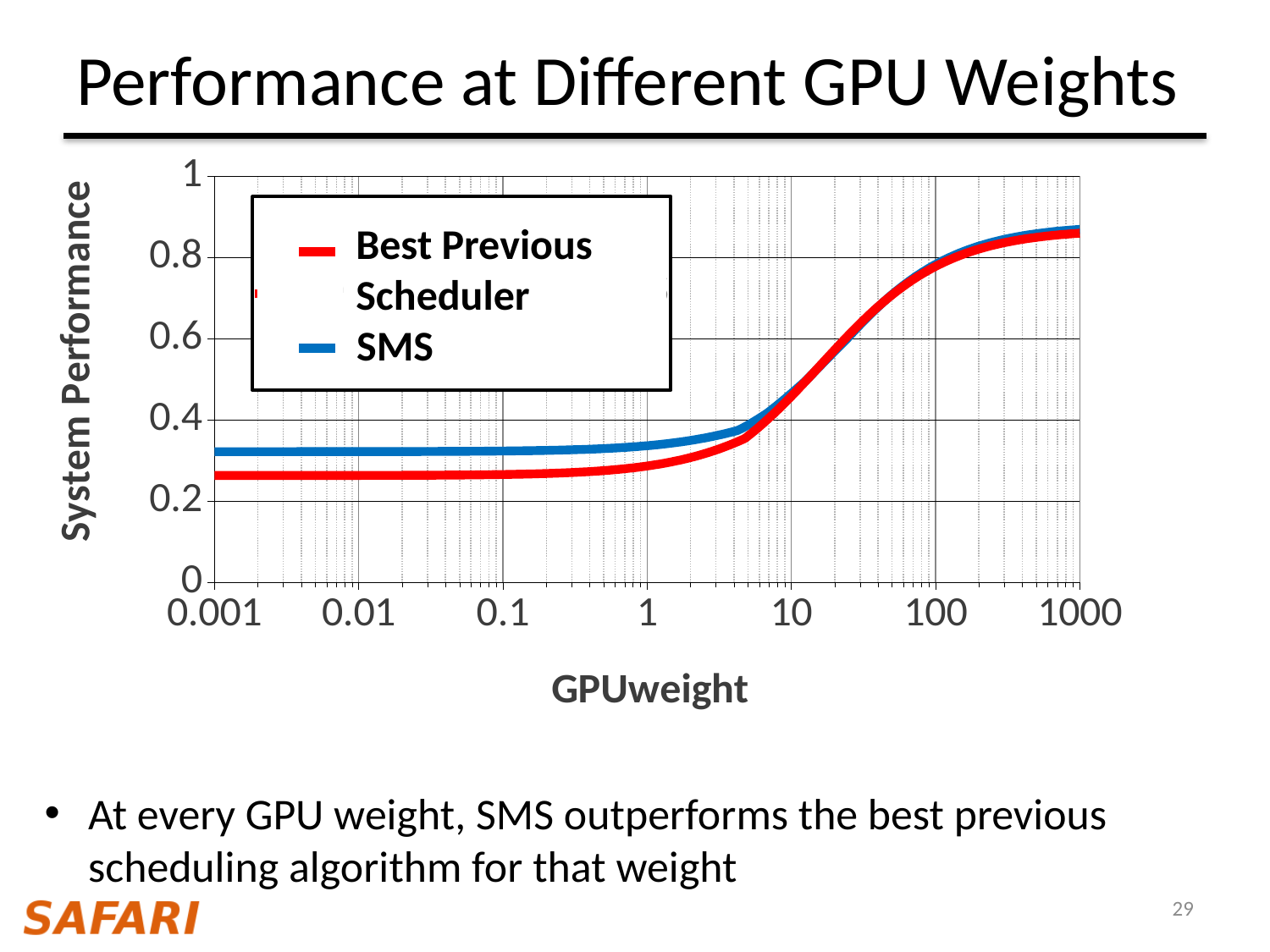
Is the value for SMS at GPUweight 0.001 greater or less than 0.2? greater Is the value for Best Previous Scheduler at GPUweight 0.001 greater or less than 0.4? less Is the value for SMS at GPUweight 1 greater or less than 0.6? less What is the title of the chart on the slide? Performance at Different GPU Weights What is the label of the y axis? System Performance At GPUweight 0.001, which series has the higher System Performance, SMS or Best Previous Scheduler? SMS Does System Performance for SMS rise or fall as GPUweight increases from 1 to 100? rise At GPUweight 1, which series has the higher System Performance, SMS or Best Previous Scheduler? SMS What kind of chart is shown on the slide? line chart How many series does the chart's legend list? 2